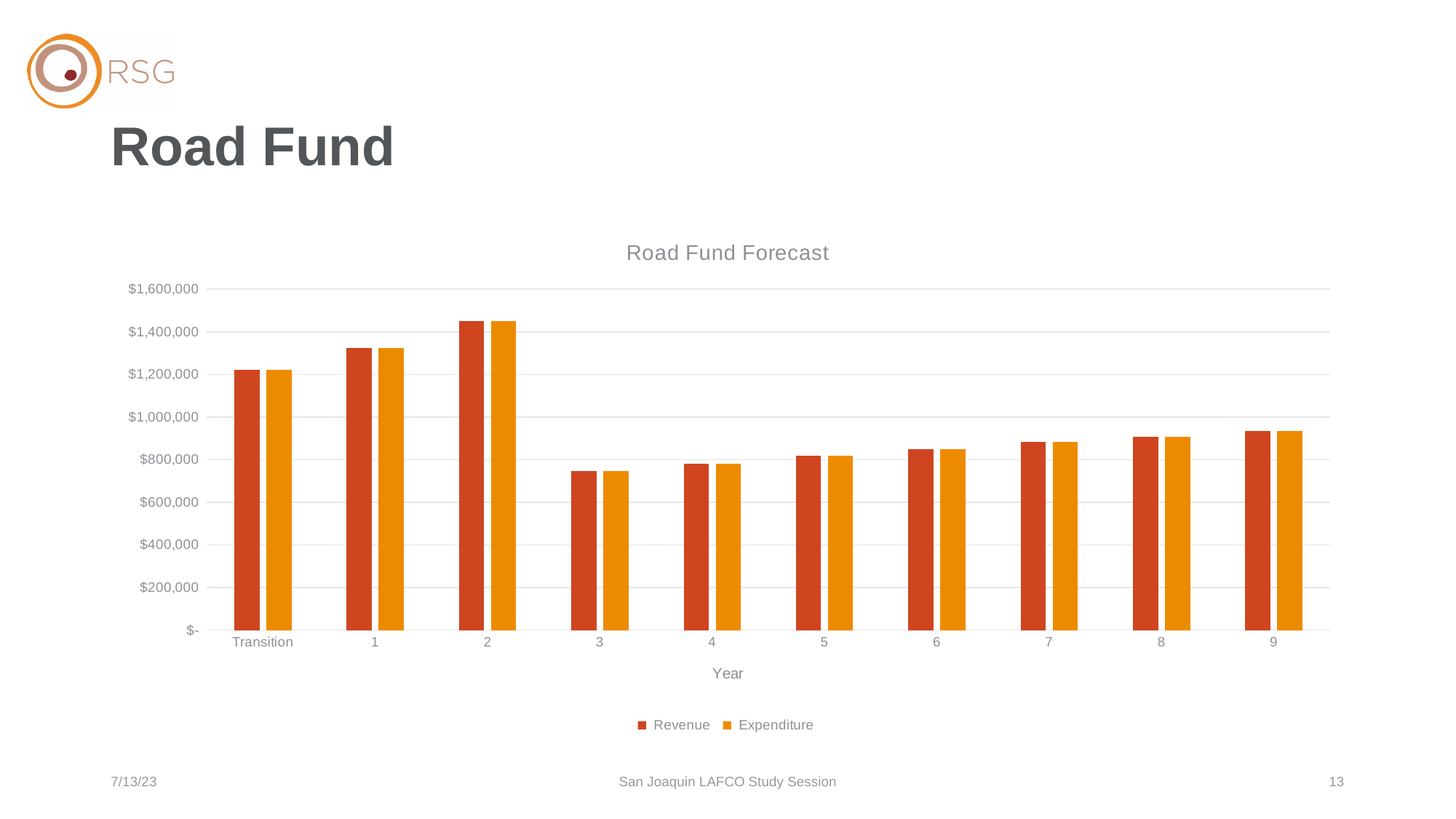
Is the Revenue value for Year 1 greater or less than $1,200,000? greater From Year 3 to Year 9, do the Revenue values rise or fall? rise Which year has the lowest Expenditure? 3 Is the Revenue value for Year 2 greater or less than $1,400,000? greater Which year has the highest Revenue? 2 What is the title of the chart? Road Fund Forecast How many categories are shown on the x axis? 10 Is the Expenditure value for Year 3 greater or less than $800,000? less How many series does the legend list? 2 Which is larger, the Revenue for Year 2 or the Revenue for Year 3? Year 2 What kind of chart is shown on the slide? bar chart